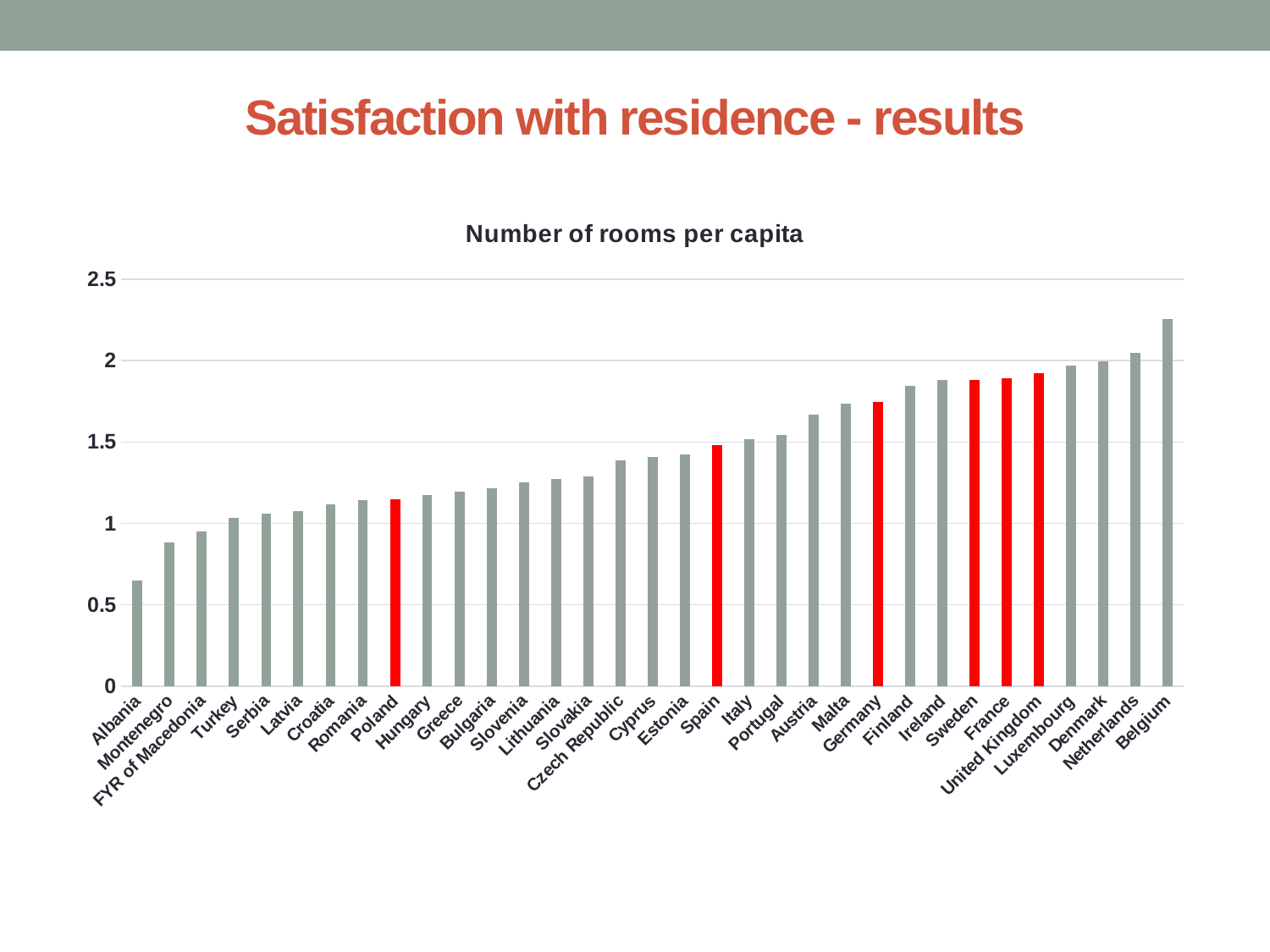
Which country has the highest number of rooms per capita? Belgium Is the value for Belgium greater or less than 2? greater Is the value for Albania greater or less than 1? less Is the value for Czech Republic greater or less than 1.5? less Which has a higher number of rooms per capita, Poland or Germany? Germany What is the title of the chart? Number of rooms per capita What kind of chart is shown on the slide? bar chart Which country has the lowest number of rooms per capita? Albania How many bars are highlighted in red? 6 How many countries are shown on the chart? 33 Do the values rise or fall moving from left to right along the x axis? rise